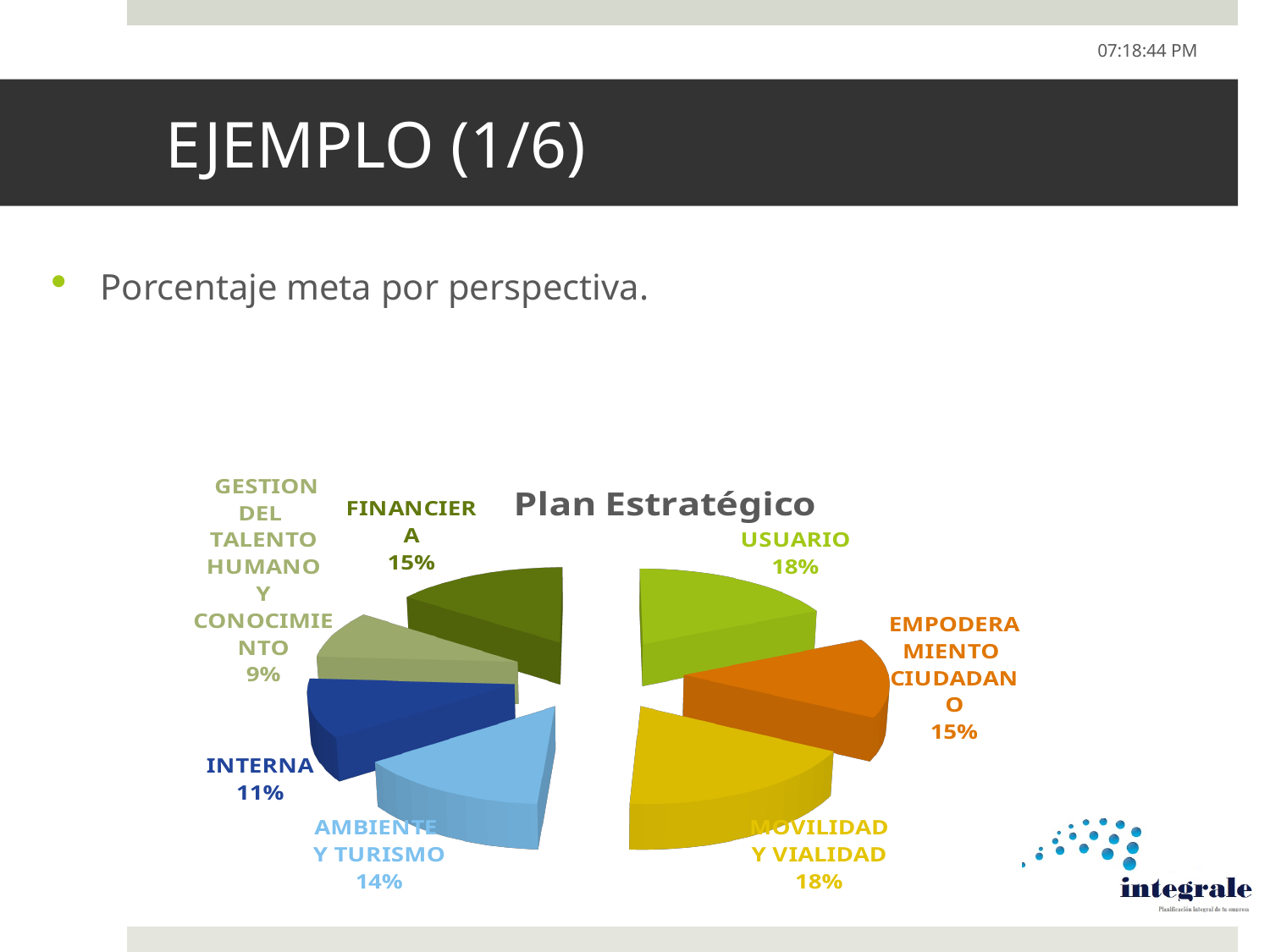
What percentage is shown for AMBIENTE Y TURISMO? 14% What type of chart is shown on the slide? Pie chart What percentage is shown for USUARIO? 18% What is the title of the chart? Plan Estratégico How many slices does the pie chart have? 7 What is the difference between the percentages for USUARIO and FINANCIERA? 3% What is the difference between the percentages for MOVILIDAD Y VIALIDAD and INTERNA? 7% What percentage is shown for INTERNA? 11% Which is larger, the share for AMBIENTE Y TURISMO or the share for GESTION DEL TALENTO HUMANO Y CONOCIMIENTO? AMBIENTE Y TURISMO What percentage is shown for FINANCIERA? 15% Which perspective has the smallest share of the pie? GESTION DEL TALENTO HUMANO Y CONOCIMIENTO What percentage is shown for EMPODERAMIENTO CIUDADANO? 15%